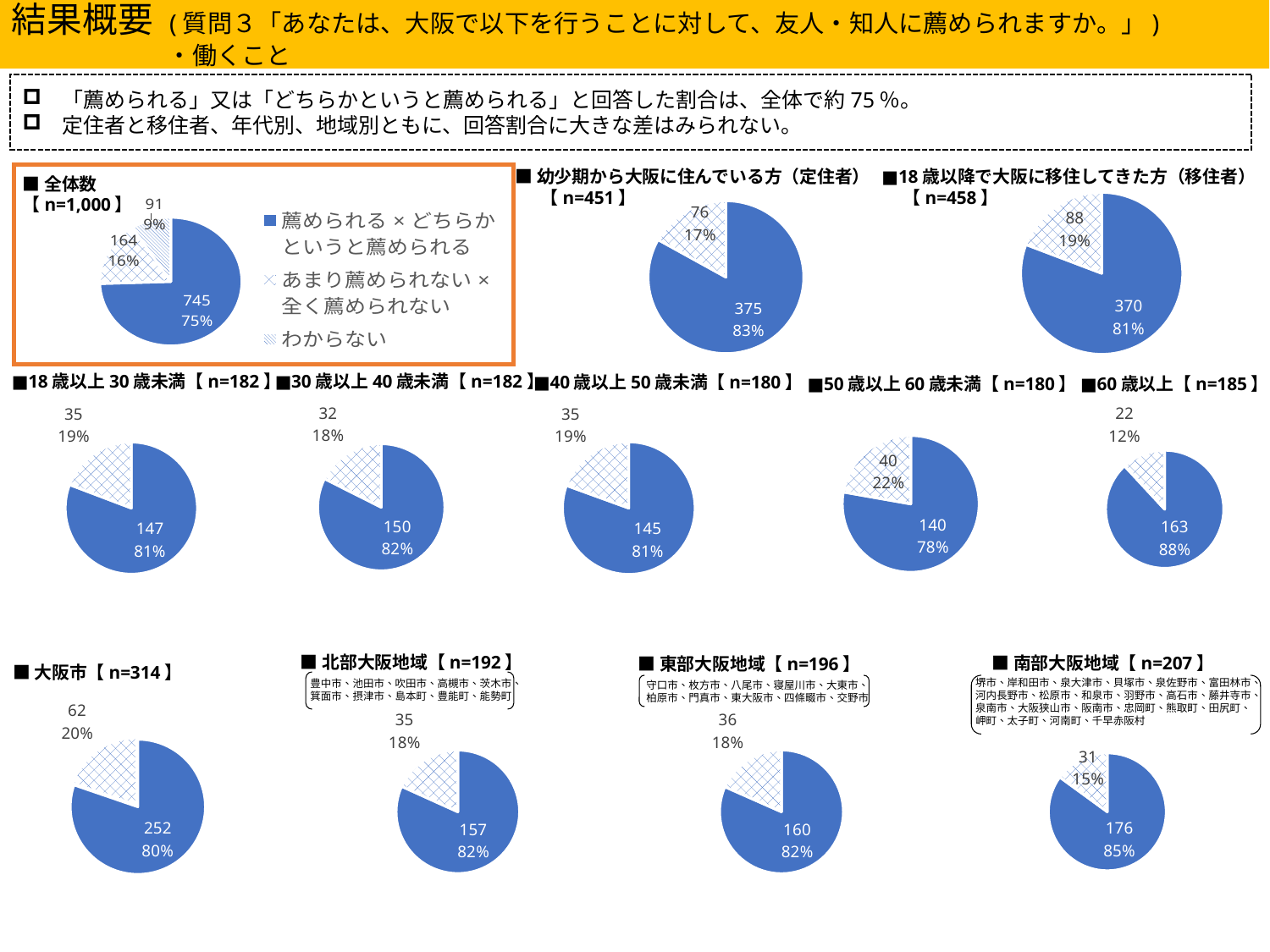
「全体数【n=1,000】」の円グラフの凡例には、いくつの項目がありますか。 3 「大阪市【n=314】」の円グラフで、「薦められる×どちらかというと薦められる」の回答数はいくつですか。 252 「50歳以上60歳未満【n=180】」の円グラフで、「あまり薦められない×全く薦められない」の回答数はいくつですか。 40 「全体数【n=1,000】」の円グラフで、「わからない」の割合は何%ですか。 9% 「東部大阪地域【n=196】」の円グラフで、「薦められる×どちらかというと薦められる」と「あまり薦められない×全く薦められない」のどちらが大きいですか。 薦められる×どちらかというと薦められる 「北部大阪地域【n=192】」のグラフはどの種類のグラフですか。 円グラフ 「30歳以上40歳未満【n=182】」の円グラフで、「薦められる×どちらかというと薦められる」と「あまり薦められない×全く薦められない」の回答数の差はいくつですか。 118 「60歳以上【n=185】」の円グラフで、「薦められる×どちらかというと薦められる」の割合は何%ですか。 88% 「南部大阪地域【n=207】」の円グラフで、「あまり薦められない×全く薦められない」の割合は何%ですか。 15% 「18歳以降で大阪に移住してきた方（移住者）【n=458】」の円グラフで、「あまり薦められない×全く薦められない」の回答数はいくつですか。 88 「全体数【n=1,000】」の円グラフで、「薦められる×どちらかというと薦められる」の回答数はいくつですか。 745